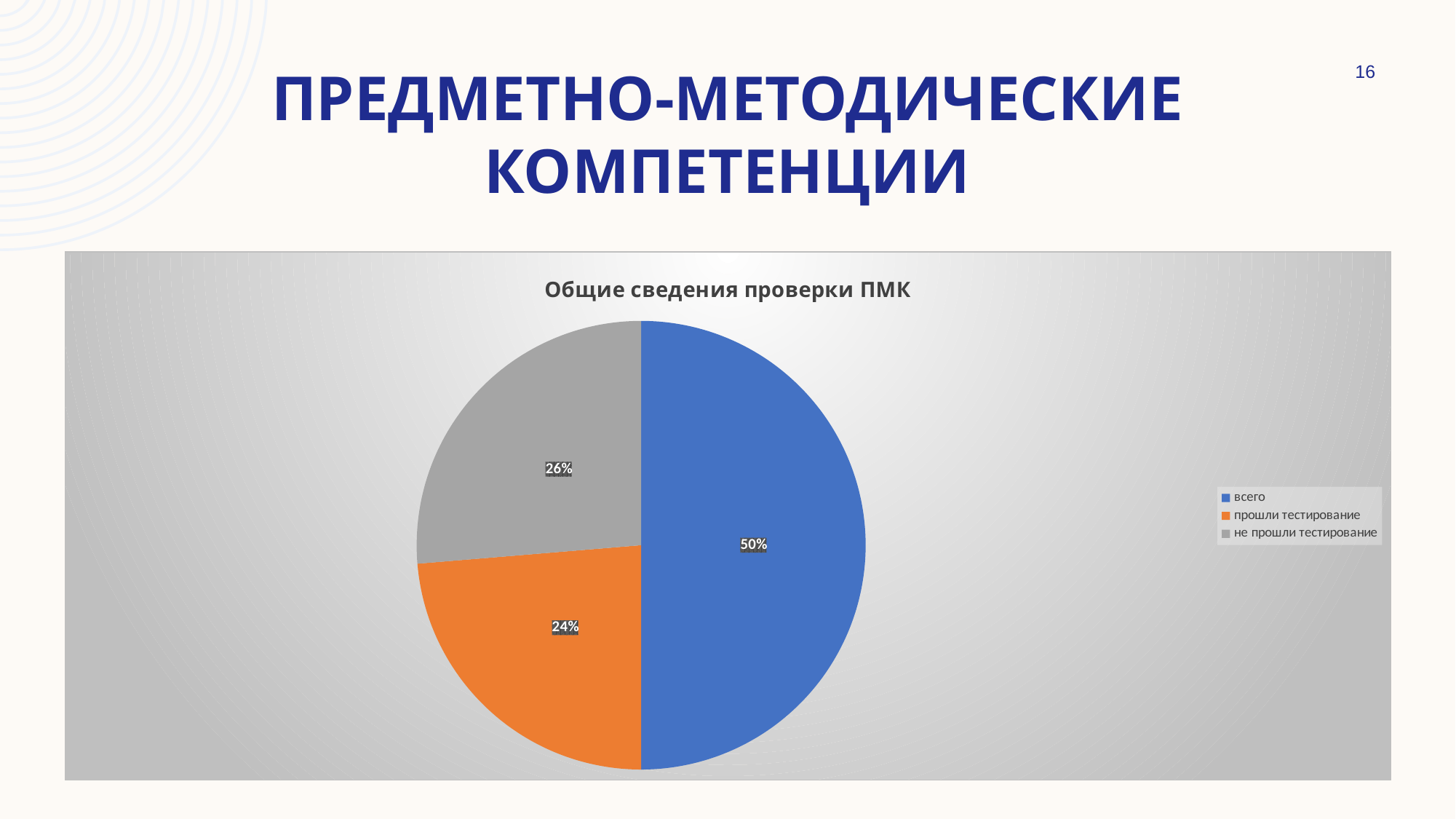
Which slice of the pie is the largest? всего Which slice of the pie is the smallest? прошли тестирование What is the title of the chart? Общие сведения проверки ПМК How many slices does the pie chart have? 3 What share of the pie does the 'не прошли тестирование' slice represent? 26% What type of chart is shown on the slide? pie chart What share of the pie does the 'прошли тестирование' slice represent? 24% How many entries does the legend list? 3 What is the difference in percentage points between the 'не прошли тестирование' slice and the 'прошли тестирование' slice? 2% Which colour represents 'прошли тестирование' in the pie chart? orange What share of the pie does the 'всего' slice represent? 50% What is the difference in percentage points between the 'всего' slice and the 'не прошли тестирование' slice? 24%